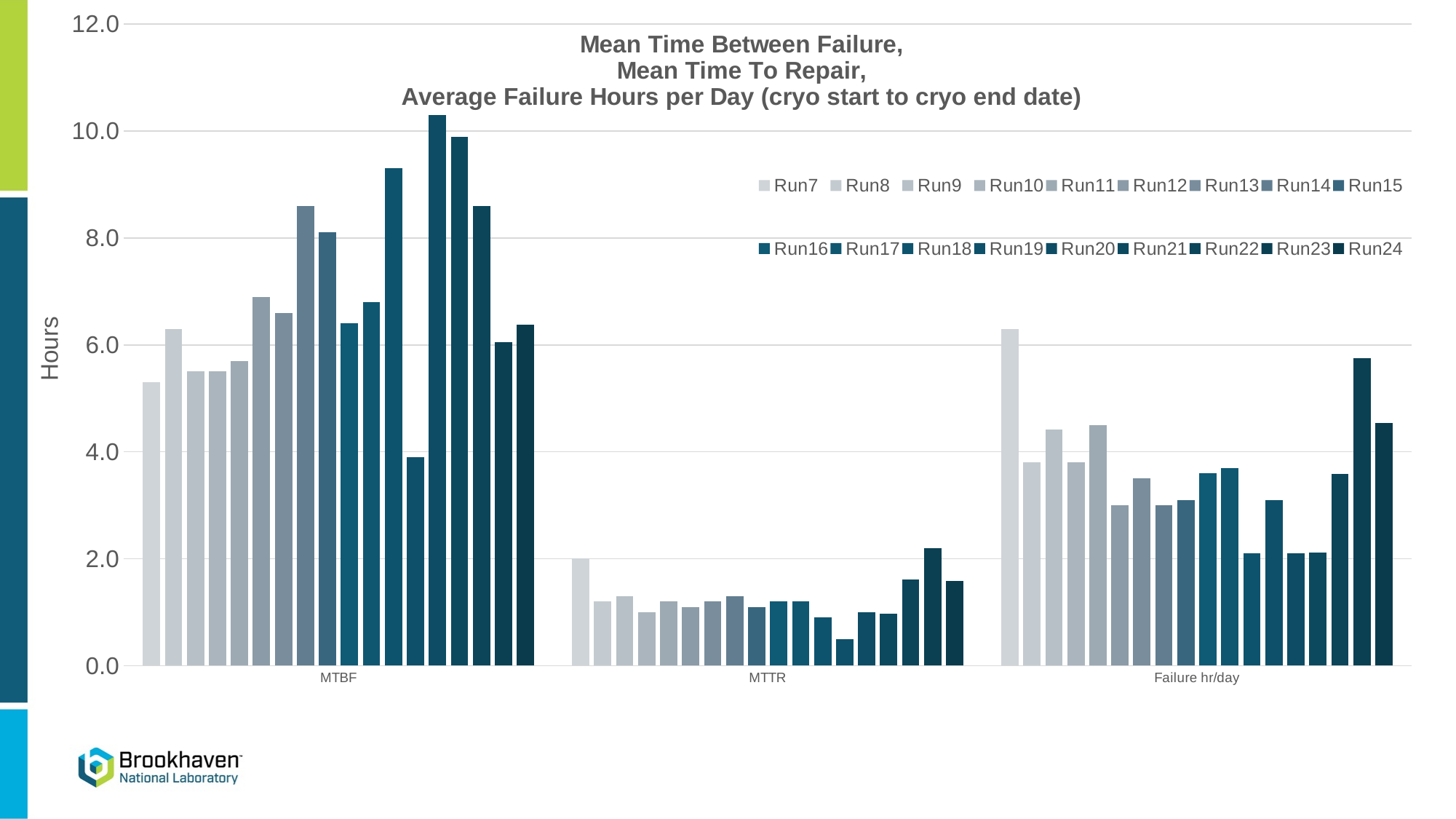
Is the Run24 value for Failure hr/day greater or less than 4.0? greater Is the Run24 value for MTTR greater or less than 2.0? less How many categories are shown on the x axis? 3 Which category has the lowest bars overall? MTTR Is the tallest bar in the MTBF category greater or less than 10.0? greater Which category contains the tallest bar in the chart? MTBF What is the highest value shown on the y axis? 12.0 What kind of chart is shown on the slide? bar chart How many series does the legend list? 18 What is the label of the y axis? Hours